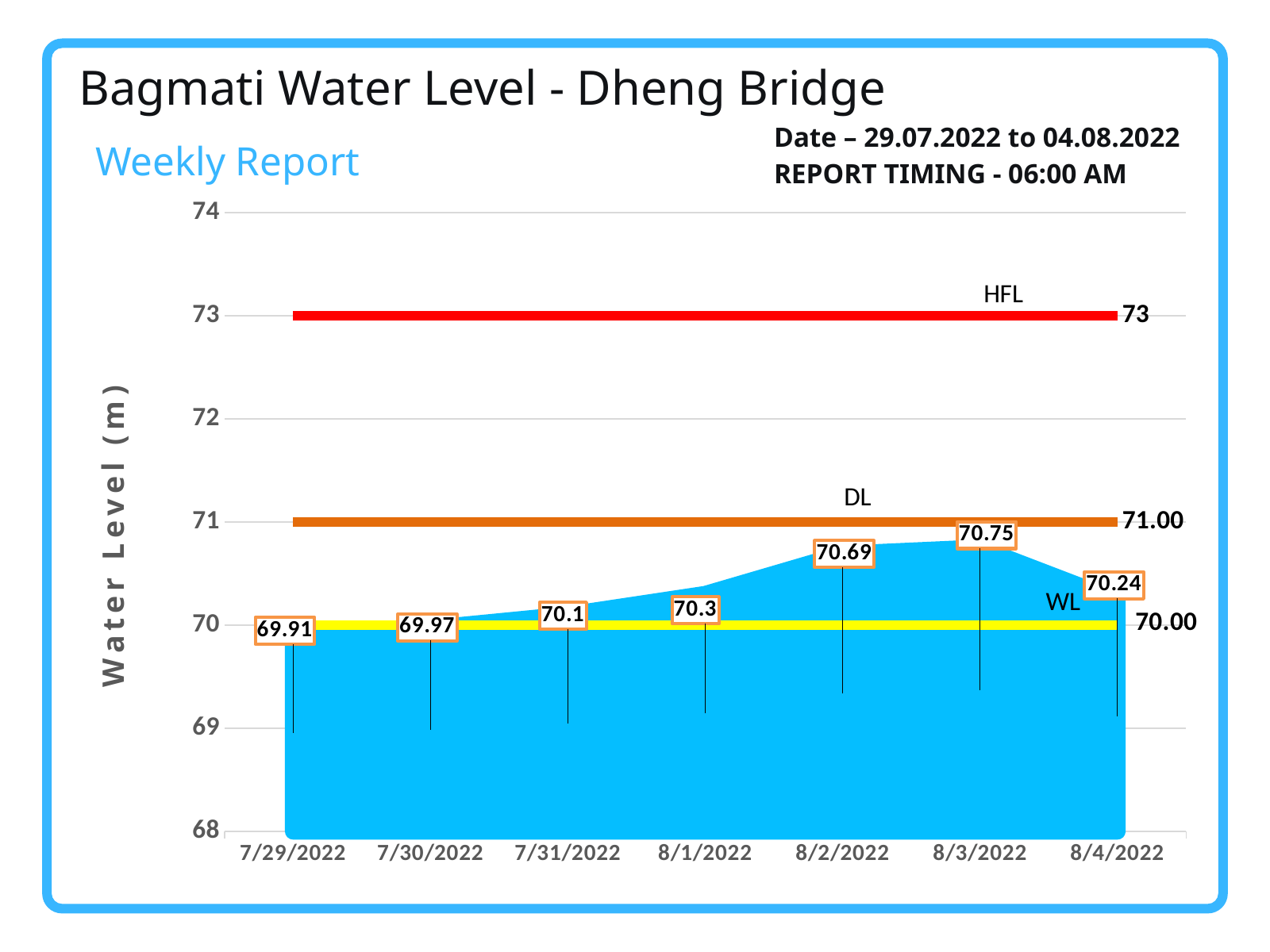
What is the value of the DL line? 71.00 What is the water level on 8/3/2022? 70.75 On which date is the water level highest? 8/3/2022 How many dates are plotted on the x axis? 7 On which date is the water level lowest? 7/29/2022 What is the water level on 8/1/2022? 70.3 What is the value of the HFL line? 73 What is the difference between the water level on 8/3/2022 and on 8/4/2022? 0.51 What is the water level on 7/29/2022? 69.91 Which date has a higher water level, 7/31/2022 or 8/2/2022? 8/2/2022 Is the water level on 8/2/2022 greater or less than 71? less What kind of chart is used to show the water level? area chart